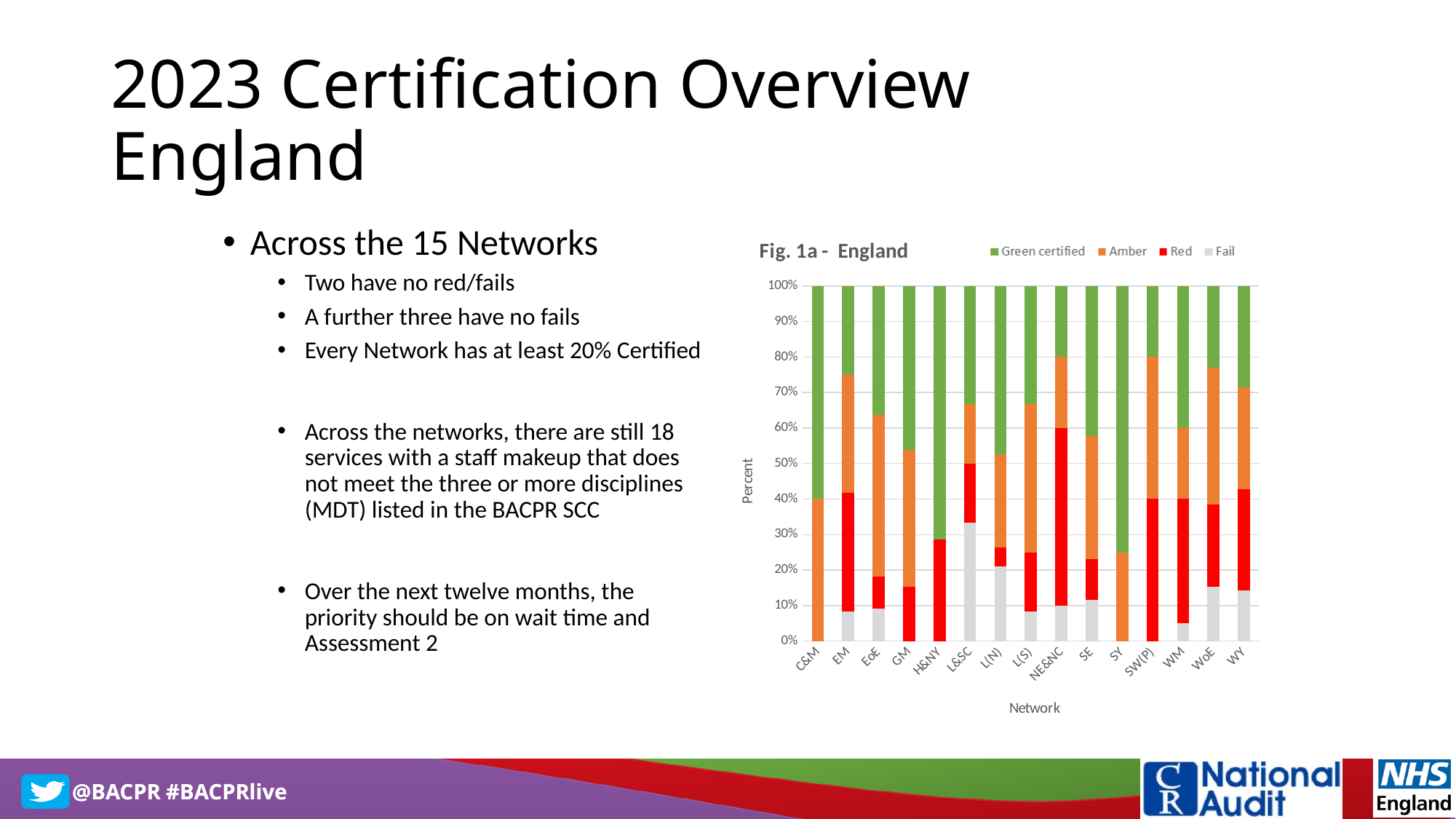
Is the Fail segment for L&SC greater or less than 30%? greater How many series does the chart legend list? 4 How many networks are shown on the x axis of the chart? 15 Is the Green certified segment for C&M greater or less than 50%? greater What is the label on the vertical axis of the chart? Percent Which network has the largest Fail segment? L&SC Is the Green certified segment for NE&NC greater or less than 30%? less What is the title of the chart? Fig. 1a - England What kind of chart is shown on the slide? Stacked bar chart Which is larger, the Fail segment for L&SC or the Fail segment for EM? L&SC Which network has the largest Red segment? NE&NC